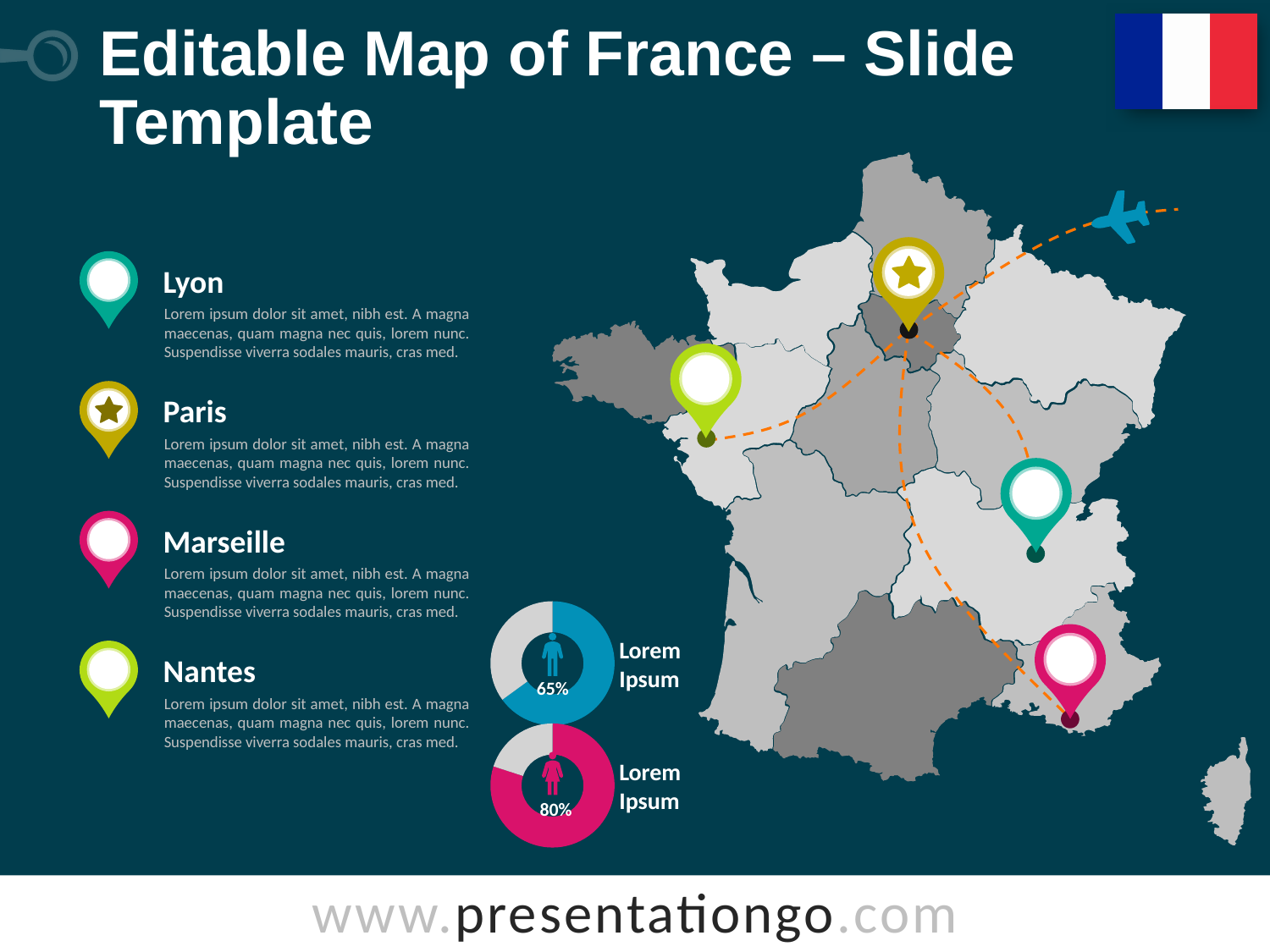
Is the value shown in the upper blue doughnut chart greater or less than 50%? greater What label text appears to the right of each doughnut chart? Lorem Ipsum What percentage is shown in the lower (pink) doughnut chart? 80% What is the difference between the percentage in the lower pink doughnut chart and the percentage in the upper blue doughnut chart? 15% In the lower pink doughnut chart, what share of the ring is not filled by the 80% segment? 20% What colour is the filled segment of the upper doughnut chart? blue How many doughnut charts are on the slide? 2 In the upper blue doughnut chart, what share of the ring is not filled by the 65% segment? 35% What kind of chart is used to display the 65% and 80% values on the slide? doughnut chart Is the value shown in the lower pink doughnut chart greater or less than 75%? greater Which doughnut chart shows the larger percentage, the upper blue one or the lower pink one? the lower pink one What percentage is shown in the upper (blue) doughnut chart? 65%